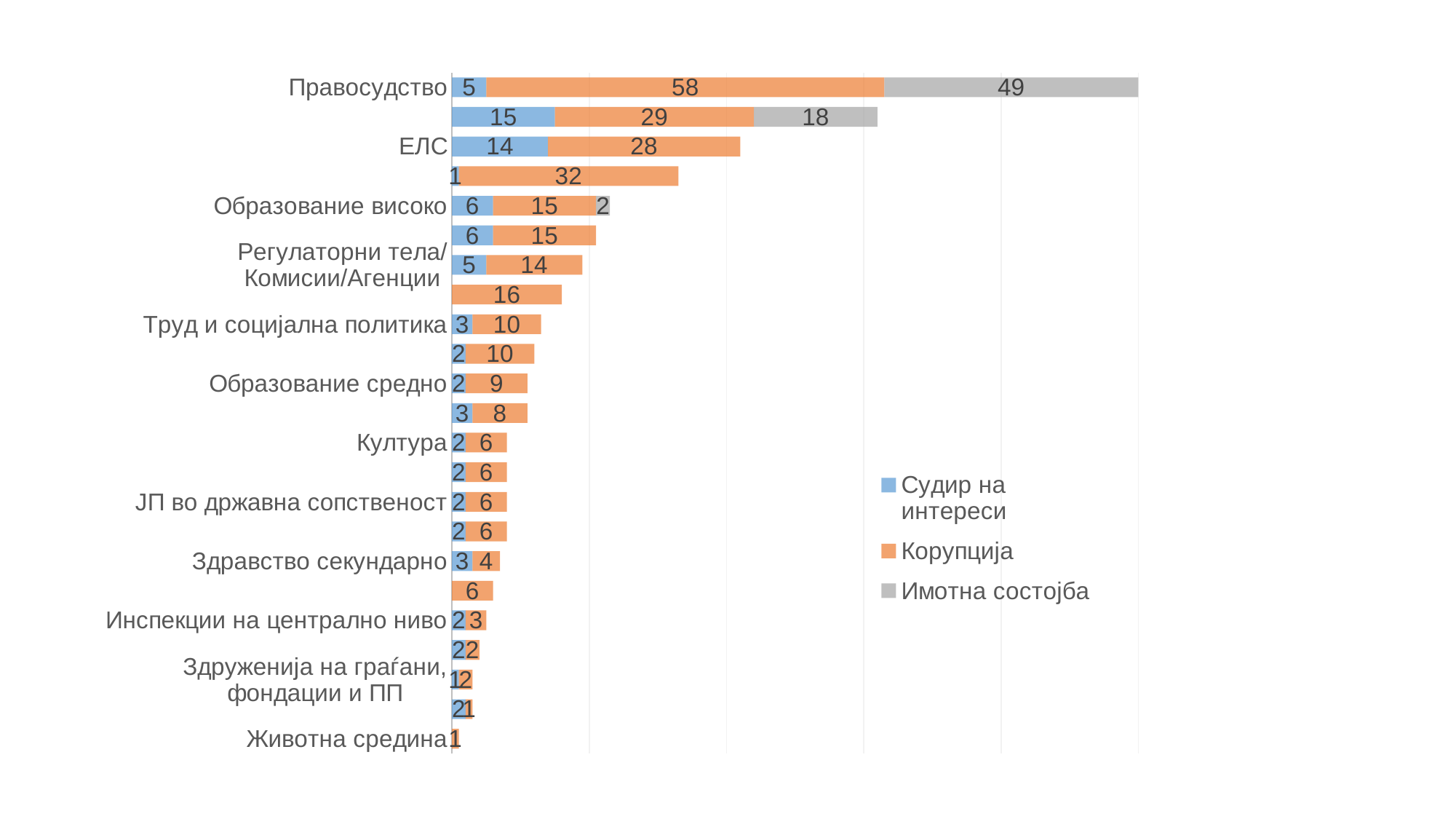
What type of chart is shown on the slide? stacked bar chart Which labelled category has the highest total? Правосудство What is the total of the stacked bar for Правосудство? 112 What is the total of the stacked bar for ЕЛС? 42 How many series does the legend list? 3 What is the value of Судир на интереси for ЕЛС? 14 What is the value of Имотна состојба for Правосудство? 49 What is the difference between the Корупција values for Правосудство and ЕЛС? 30 What is the value of Корупција for Образование високо? 15 Which is larger: the Корупција value for Труд и социјална политика or for Здравство секундарно? Труд и социјална политика Which legend entry is shown in gray? Имотна состојба What is the value of Корупција for Правосудство? 58